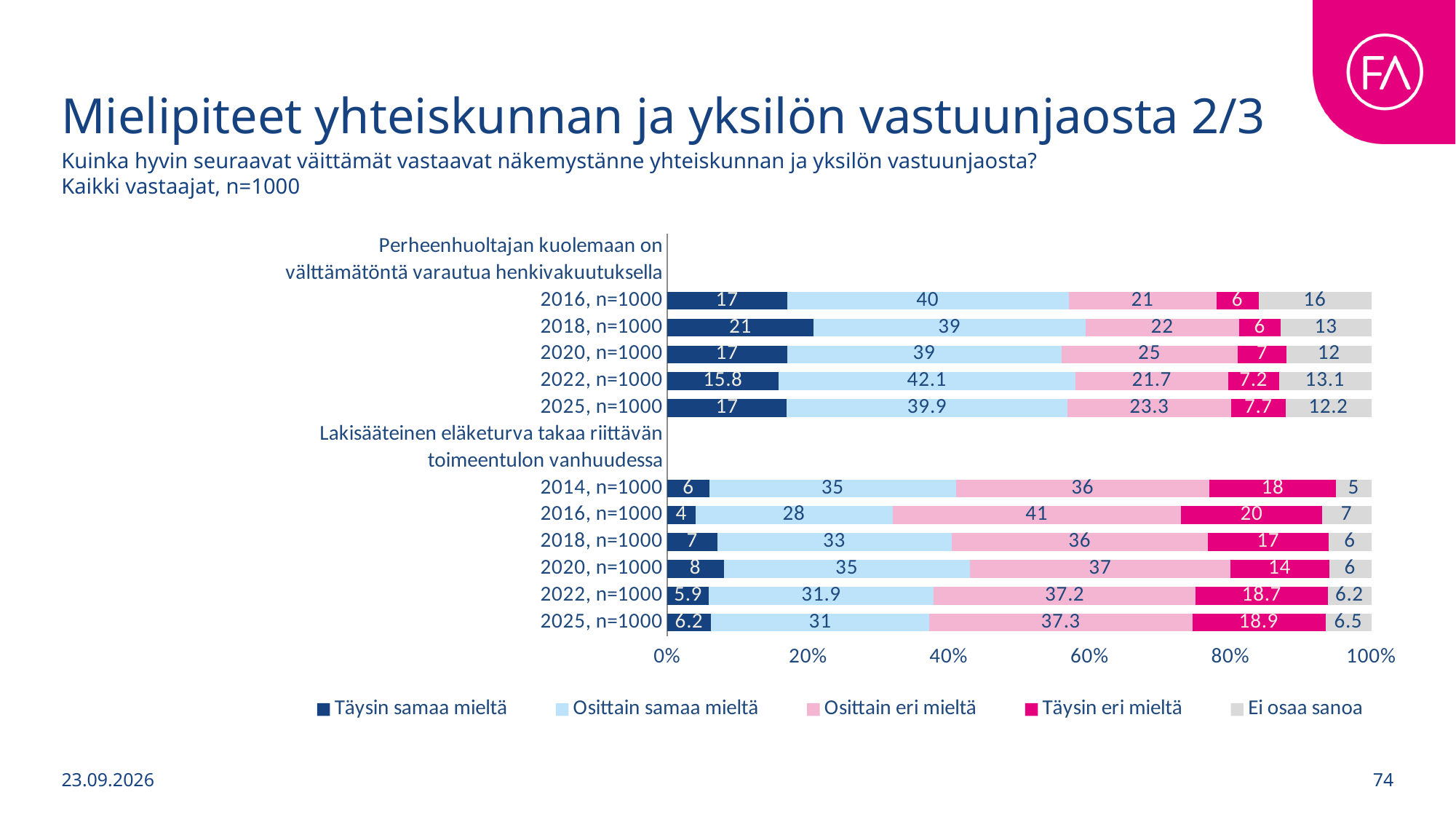
How many series does the legend list? 5 Which legend entry is shown in dark blue? Täysin samaa mieltä For the statement 'Lakisääteinen eläketurva takaa riittävän toimeentulon vanhuudessa', which year has the lowest 'Täysin samaa mieltä' value? 2016, n=1000 How many bars (year rows) are plotted in the chart in total? 11 What kind of chart is shown on the slide? Stacked bar chart For the statement 'Perheenhuoltajan kuolemaan on välttämätöntä varautua henkivakuutuksella', what is the 'Osittain samaa mieltä' value for 2022, n=1000? 42.1 For the statement 'Lakisääteinen eläketurva takaa riittävän toimeentulon vanhuudessa', what is the difference between the 'Täysin eri mieltä' values for 2022, n=1000 and 2020, n=1000? 4.7 For the statement 'Lakisääteinen eläketurva takaa riittävän toimeentulon vanhuudessa', what is the 'Täysin eri mieltä' value for 2025, n=1000? 18.9 For the statement 'Lakisääteinen eläketurva takaa riittävän toimeentulon vanhuudessa', what is the difference between the 'Osittain eri mieltä' values for 2016, n=1000 and 2014, n=1000? 5 For the statement 'Perheenhuoltajan kuolemaan on välttämätöntä varautua henkivakuutuksella', which is larger: the 'Ei osaa sanoa' value for 2016, n=1000 or for 2025, n=1000? 2016, n=1000 For the statement 'Perheenhuoltajan kuolemaan on välttämätöntä varautua henkivakuutuksella', which year has the highest 'Täysin samaa mieltä' value? 2018, n=1000 For the statement 'Lakisääteinen eläketurva takaa riittävän toimeentulon vanhuudessa', what is the 'Ei osaa sanoa' value for 2014, n=1000? 5